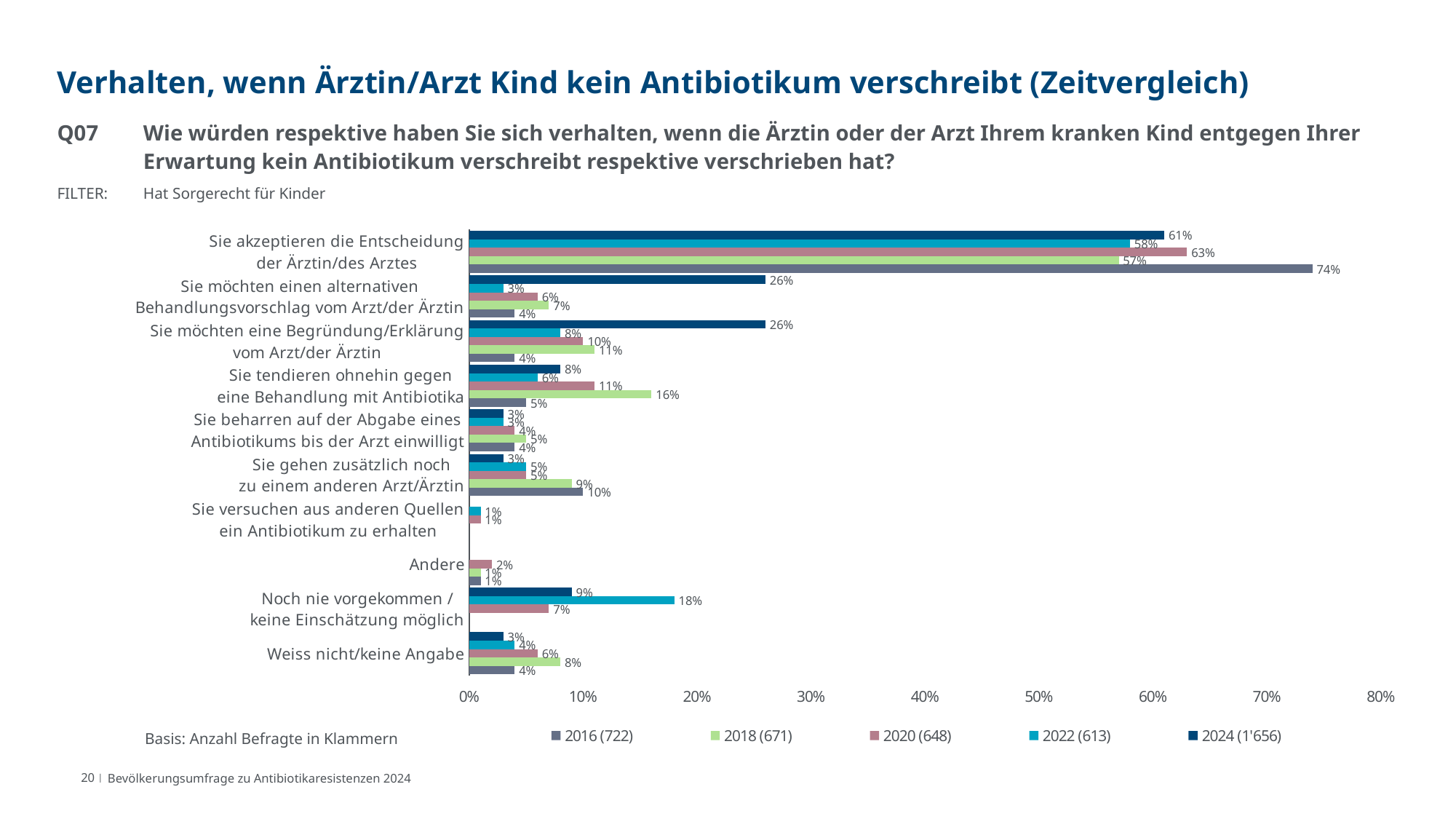
Which year has the highest value for "Sie akzeptieren die Entscheidung der Ärztin/des Arztes"? 2016 How many response categories are shown on the chart? 10 How many series does the legend list? 5 What is the 2018 value for "Sie tendieren ohnehin gegen eine Behandlung mit Antibiotika"? 16% Which year has the lowest value for "Sie gehen zusätzlich noch zu einem anderen Arzt/Ärztin"? 2024 What kind of chart is shown on the slide? Bar chart What is the 2022 value for "Noch nie vorgekommen / keine Einschätzung möglich"? 18% What is the 2016 value for "Sie akzeptieren die Entscheidung der Ärztin/des Arztes"? 74% What is the difference between the 2024 and 2022 values for "Sie möchten einen alternativen Behandlungsvorschlag vom Arzt/der Ärztin"? 23 percentage points What is the 2024 value for "Sie möchten eine Begründung/Erklärung vom Arzt/der Ärztin"? 26% Is the 2020 value for "Sie akzeptieren die Entscheidung der Ärztin/des Arztes" greater or less than 60%? greater Which is larger for "Weiss nicht/keine Angabe": the 2018 value or the 2020 value? 2018